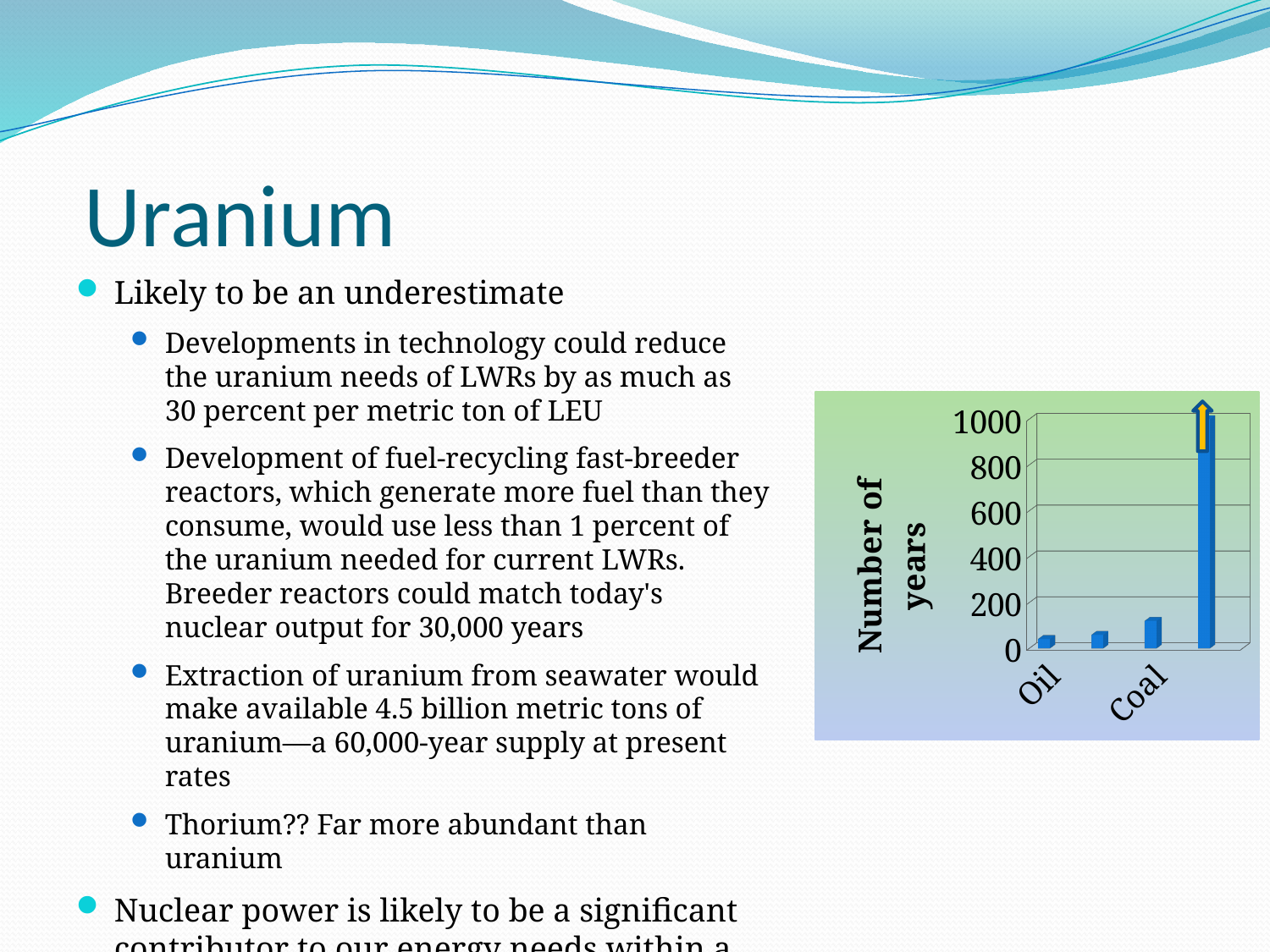
What kind of chart is shown on the slide? bar chart How many bars are plotted in the chart? 4 Is the tallest bar in the chart greater or less than 800? greater Is the value for Oil greater or less than 200? less Is the value for Oil greater or less than 400? less What is the label on the vertical axis of the chart? Number of years What is the highest tick value shown on the vertical axis? 1000 Which is larger, the value for Oil or the value for Coal? Coal